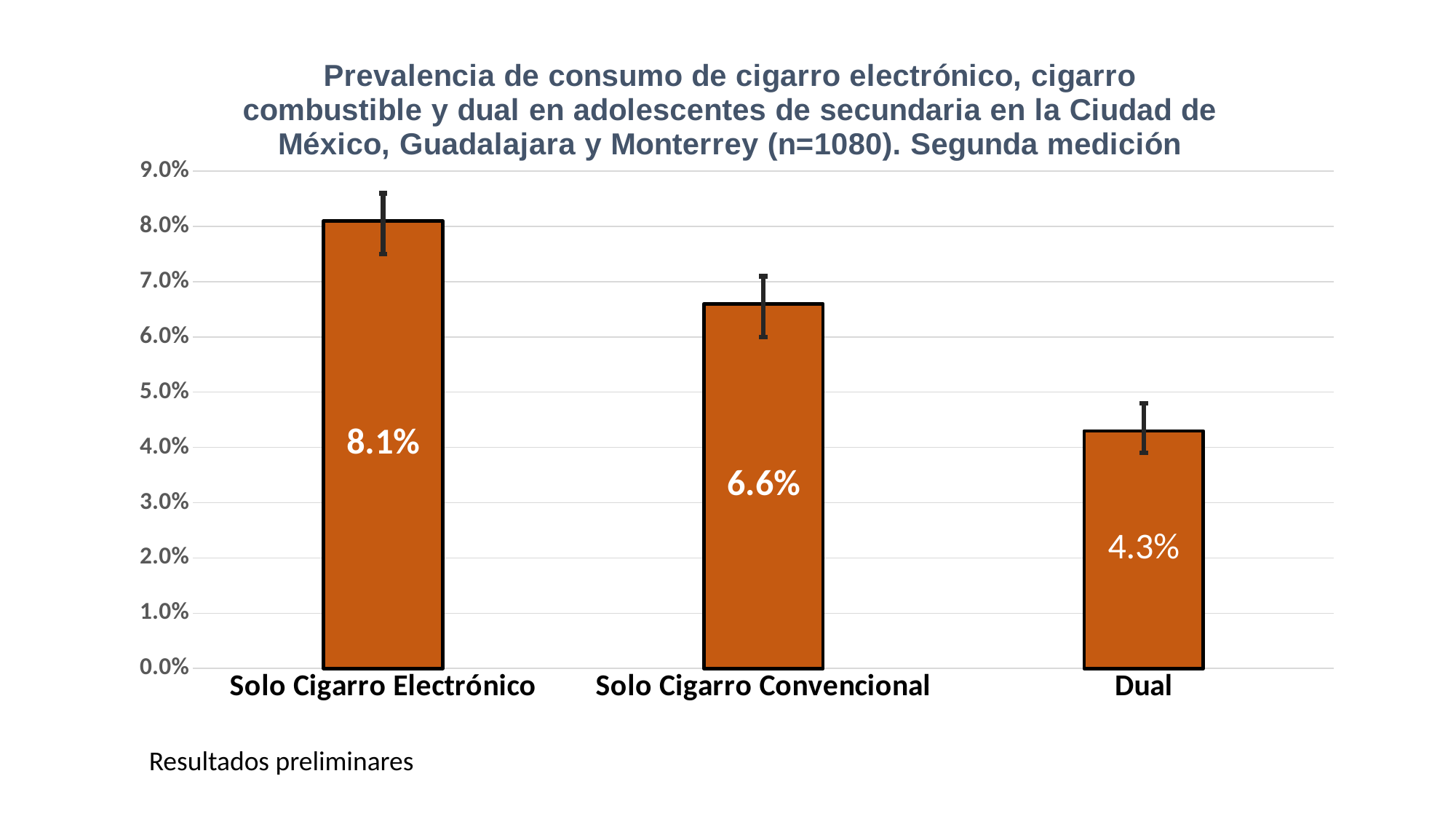
Which category has the lowest value? Dual What is the difference between the values for Solo Cigarro Electrónico and Solo Cigarro Convencional? 1.5% What kind of chart is shown on the slide? bar chart Do the values rise or fall from left to right along the x axis? fall Which is larger, the value for Solo Cigarro Convencional or the value for Dual? Solo Cigarro Convencional What is the value for Dual? 4.3% How many categories are shown on the x axis? 3 What is the difference between the values for Solo Cigarro Electrónico and Dual? 3.8% Is the value for Solo Cigarro Convencional greater or less than 7.0%? less What is the value for Solo Cigarro Convencional? 6.6% Which category has the highest value? Solo Cigarro Electrónico What is the value for Solo Cigarro Electrónico? 8.1%